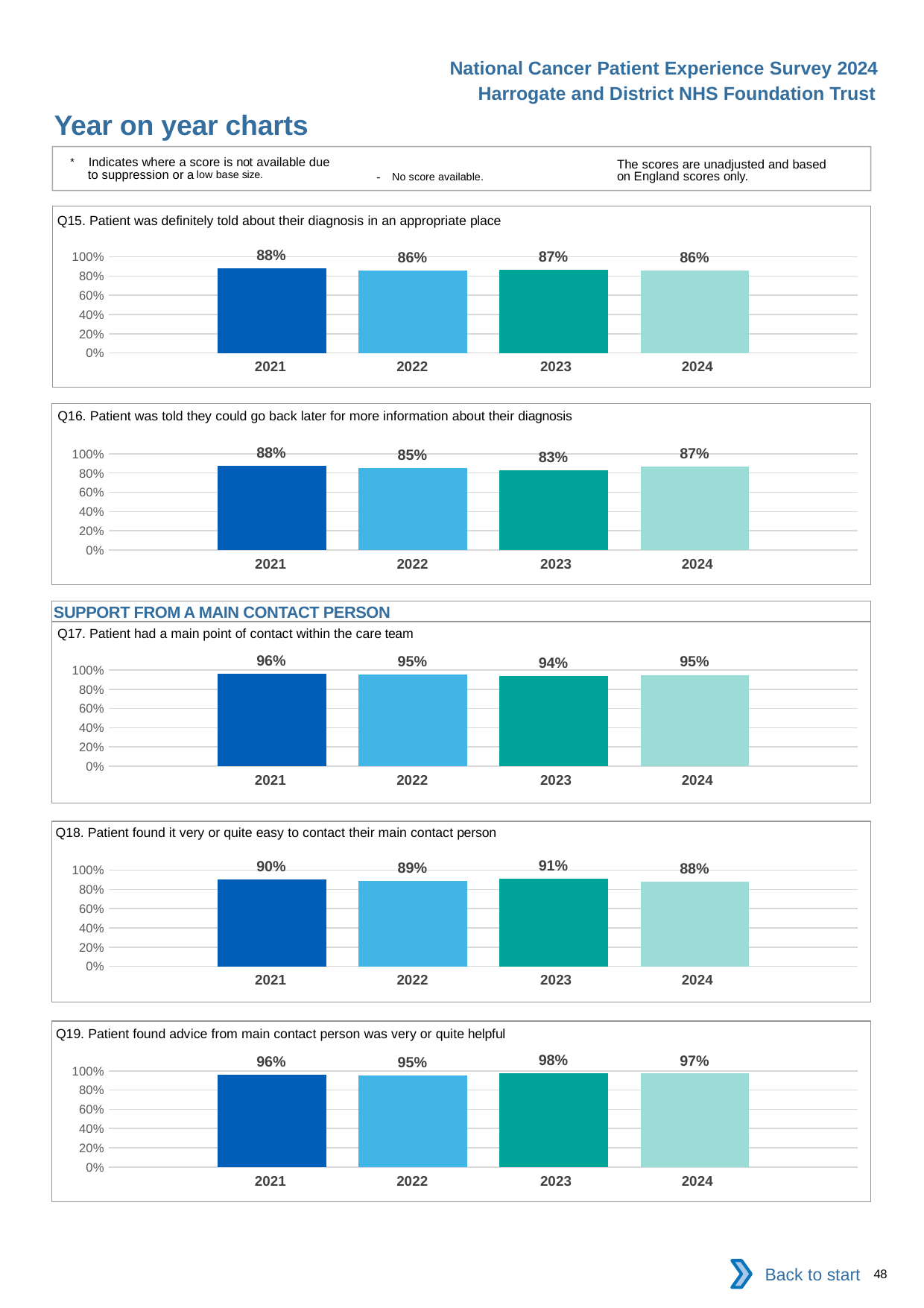
In the Q18 chart (patient found it very or quite easy to contact their main contact person), which year has the highest value? 2023 What kind of chart is used for Q16? bar chart In the Q16 chart, what is the difference between the 2021 and 2023 values? 5 percentage points What is the section heading printed above the Q17 chart? SUPPORT FROM A MAIN CONTACT PERSON In the Q17 chart (patient had a main point of contact within the care team), what is the value for 2024? 95% In the Q16 chart (patient was told they could go back later for more information), which year has the lowest value? 2023 In the Q15 chart (patient was definitely told about their diagnosis in an appropriate place), what is the value for 2021? 88% In the Q18 chart, is the value for 2022 larger or smaller than the value for 2024? larger In the Q19 chart, what is the difference between the 2023 and 2022 values? 3 percentage points In the Q19 chart (patient found advice from main contact person was very or quite helpful), what is the value for 2023? 98% How many years are shown on the x axis of the Q15 chart? 4 In the Q17 chart, which year has the highest value? 2021